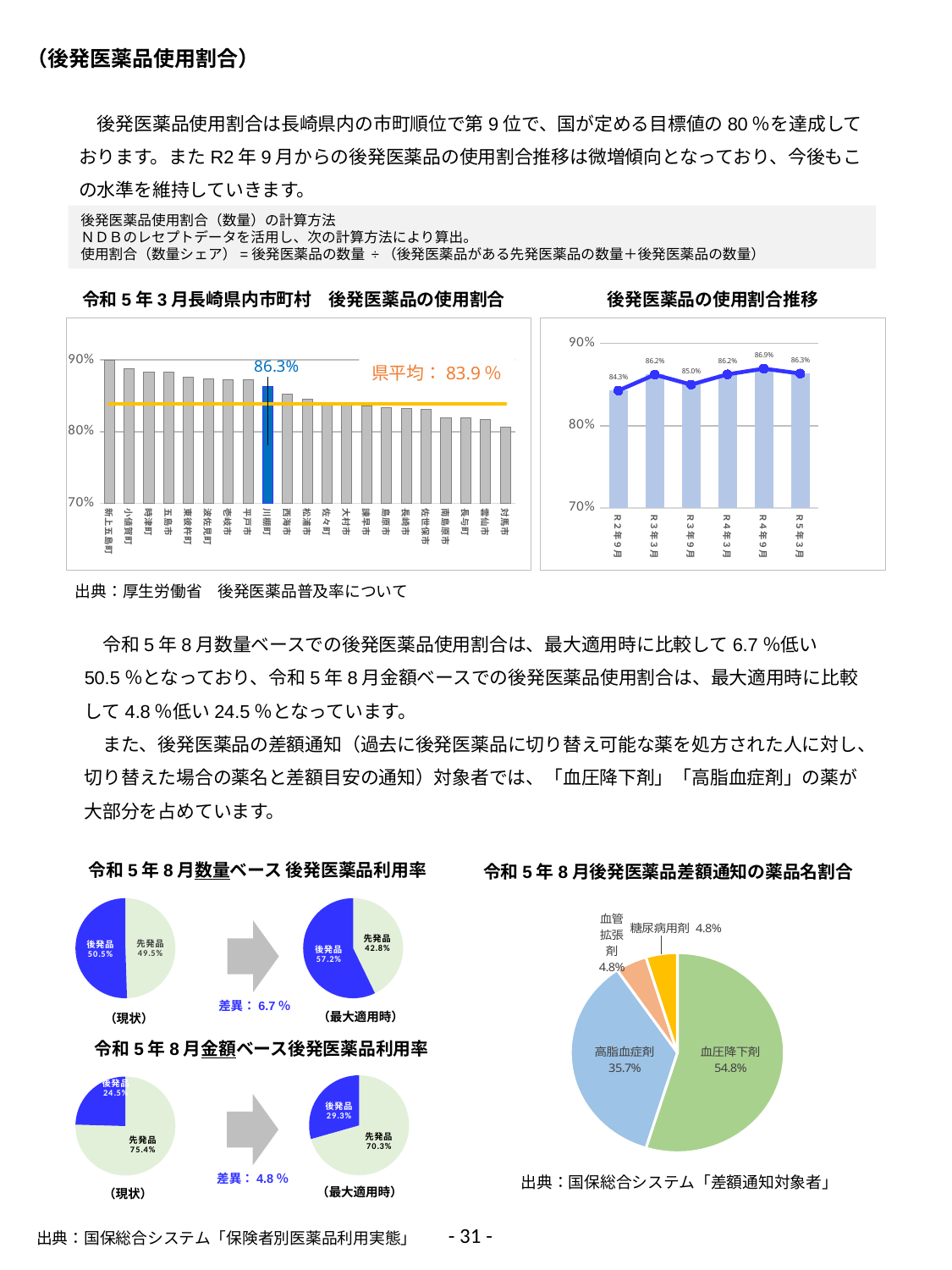
「令和5年3月長崎県内市町村 後発医薬品の使用割合」のグラフで、対馬市の値は80%より大きいですか、小さいですか？ 大きい 「後発医薬品の使用割合推移」のグラフで、最も値が低い時点はいつですか？ R2年9月 「令和5年3月長崎県内市町村 後発医薬品の使用割合」のグラフで、川棚町の値はいくつですか？ 86.3% 「令和5年8月後発医薬品差額通知の薬品名割合」の円グラフで、高脂血症剤と血圧降下剤の割合の差はいくつですか？ 19.1% 「令和5年3月長崎県内市町村 後発医薬品の使用割合」のグラフで、最も使用割合が高い市町はどこですか？ 新上五島町 「令和5年8月数量ベース 後発医薬品利用率」の現状の円グラフで、後発品の割合はいくつですか？ 50.5% 「後発医薬品の使用割合推移」のグラフで、R4年9月の値はいくつですか？ 86.9% 「令和5年3月長崎県内市町村 後発医薬品の使用割合」のグラフで、最も使用割合が低い市町はどこですか？ 対馬市 「令和5年3月長崎県内市町村 後発医薬品の使用割合」のグラフには、いくつの市町が示されていますか？ 21 「令和5年8月金額ベース後発医薬品利用率」の最大適用時の円グラフで、先発品の割合はいくつですか？ 70.3% 「令和5年3月長崎県内市町村 後発医薬品の使用割合」のグラフで、県平均の値はいくつですか？ 83.9％ 「後発医薬品の使用割合推移」のグラフには、いくつのデータ点がありますか？ 6